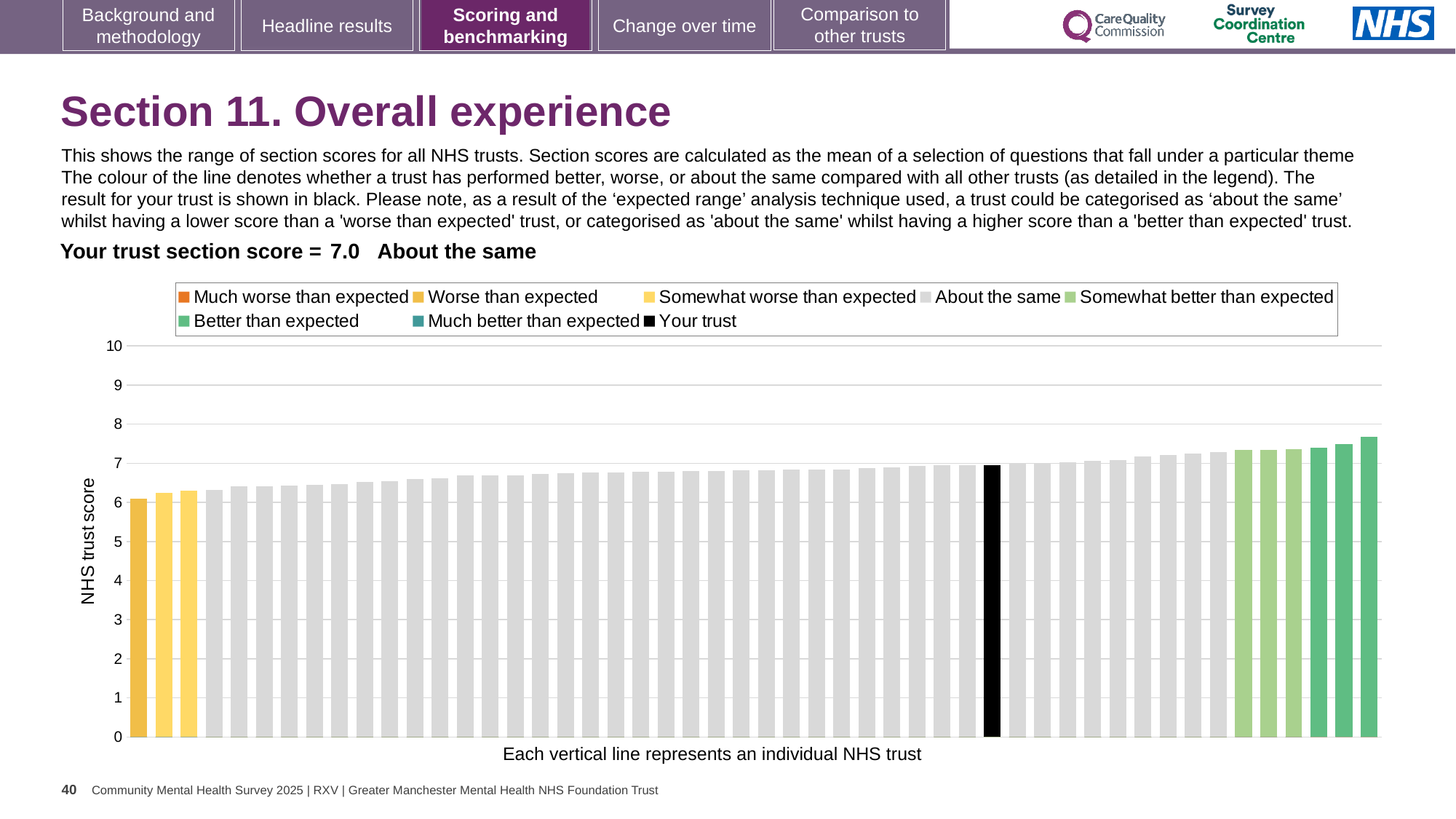
Is the value of the black 'Your trust' bar greater or less than 6? greater Is the value of the leftmost bar greater or less than 7? less How many bars are coloured in the darker green 'Better than expected' colour? 3 How many bars are coloured in the light green 'Somewhat better than expected' colour? 3 What is the label on the vertical axis of the chart? NHS trust score Do the bar values rise or fall from left to right along the x axis? Rise Is the value of the rightmost (highest) bar greater or less than 7? greater What colour is used for the 'Your trust' bar in the chart? Black What kind of chart is shown on the slide? Bar chart How many entries does the chart legend list? 8 Which category is your trust placed in for this section? About the same What is the section score for your trust shown on the slide? 7.0